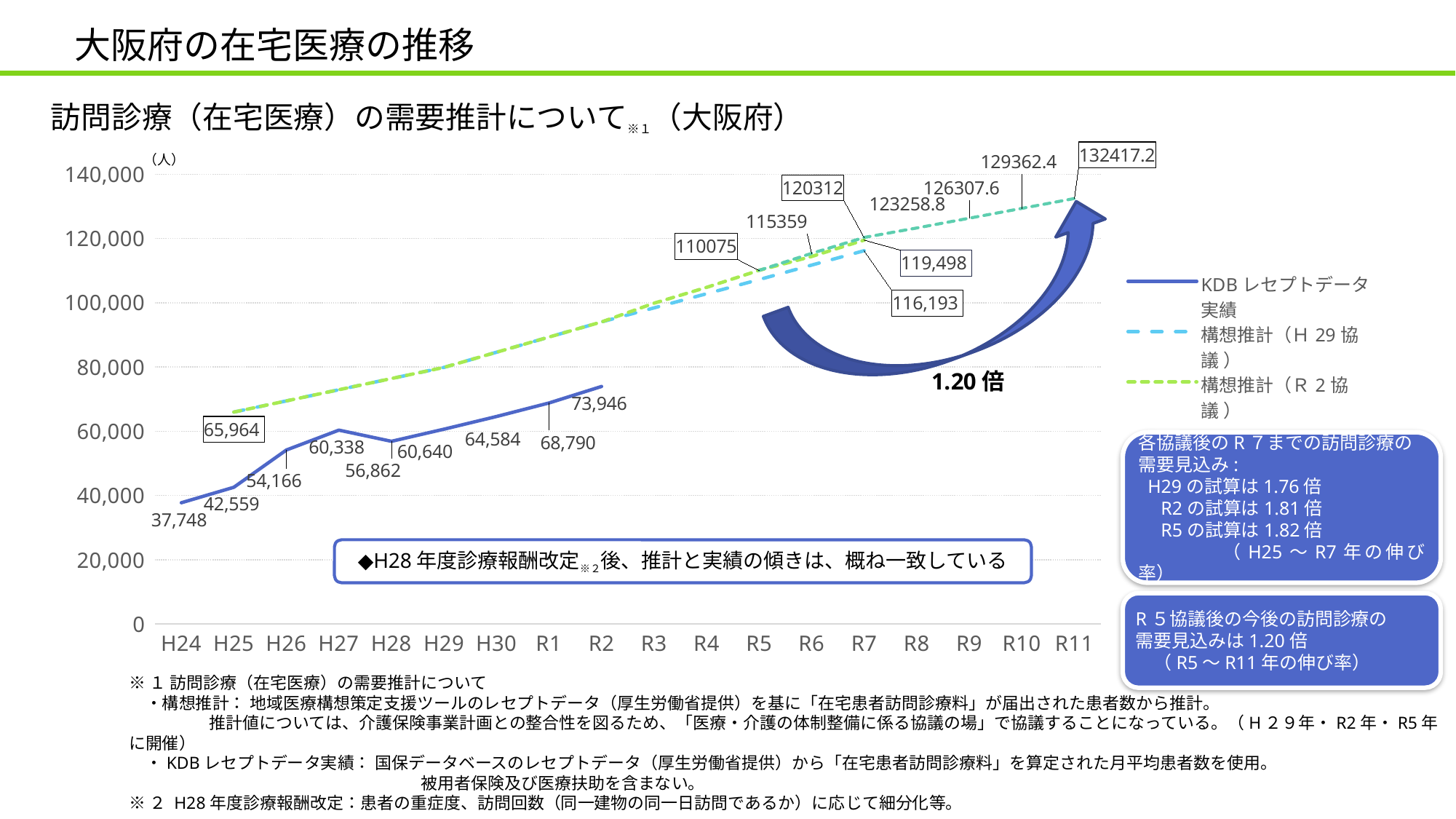
Is the dashed estimate value at R2 greater or less than 80,000? greater What is the difference between the KDBレセプトデータ実績 values for R2 and H24? 36,198 What is the KDBレセプトデータ実績 value for H28? 56,862 Which is larger for KDBレセプトデータ実績, H27 or H28? H27 How many series does the legend list? 3 In which year is the KDBレセプトデータ実績 series lowest? H24 In which year is the KDBレセプトデータ実績 series highest? R2 What is the KDBレセプトデータ実績 value for H24? 37,748 How many year categories are shown on the x axis? 18 What is the value labeled at R11 at the end of the dashed estimate line? 132417.2 What is the KDBレセプトデータ実績 value for R2? 73,946 What is the value labeled at H25 where the dashed estimate lines begin? 65,964